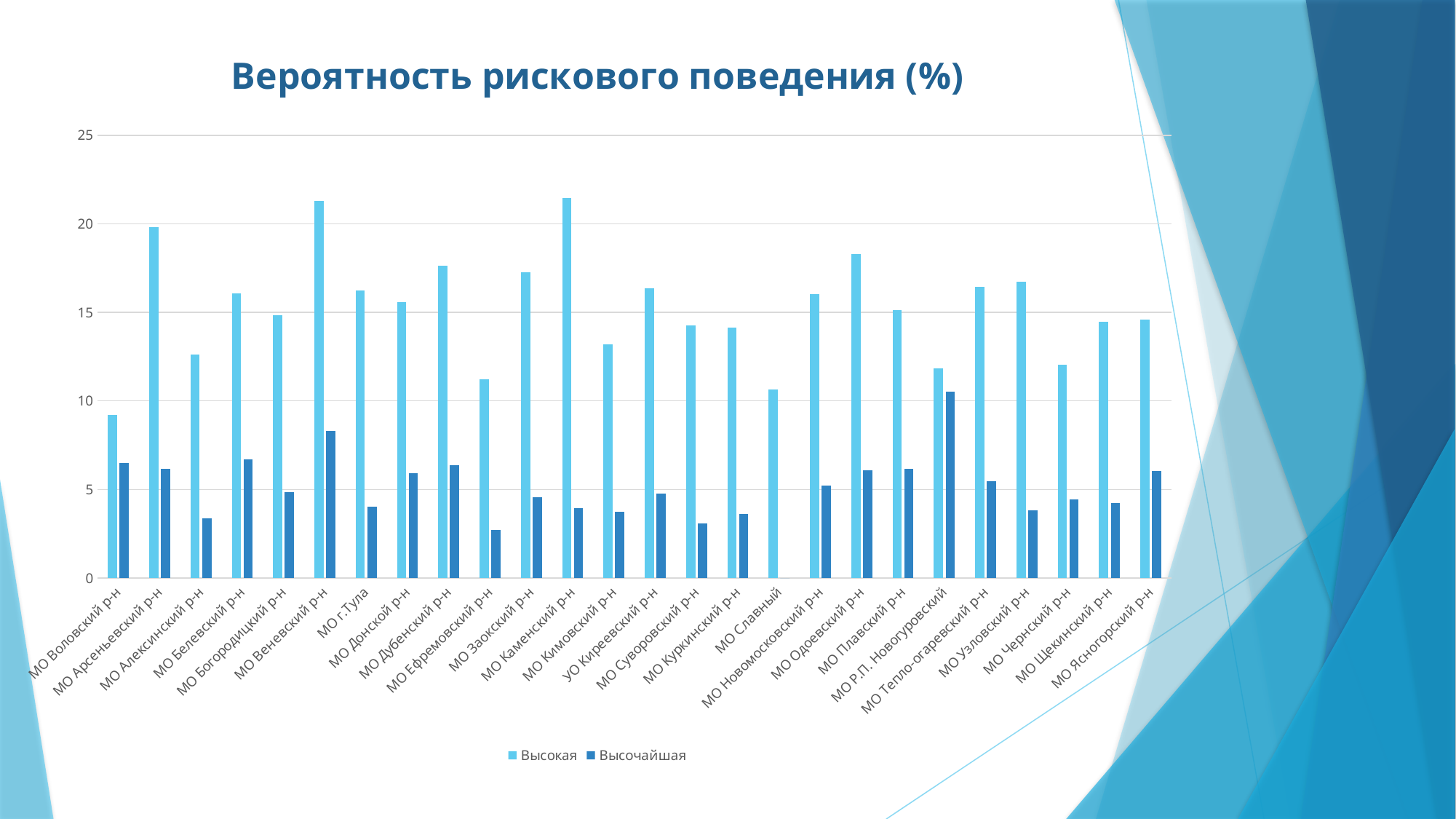
How many categories (municipalities) are shown on the x axis? 26 What is the title of the chart? Вероятность рискового поведения (%) What kind of chart is shown on the slide? bar chart Is the Высокая value for МО Воловский р-н greater or less than 10? less Which category has the lowest value for the Высокая series? МО Воловский р-н What are the two series named in the legend? Высокая, Высочайшая Which has the larger Высокая value: МО Арсеньевский р-н or МО Алексинский р-н? МО Арсеньевский р-н Which category has the highest value for the Высочайшая series? МО Р.П. Новогуровский How many series does the legend list? 2 Is the Высокая value for МО Арсеньевский р-н greater or less than 15? greater Is the Высочайшая value for МО Ефремовский р-н greater or less than 5? less